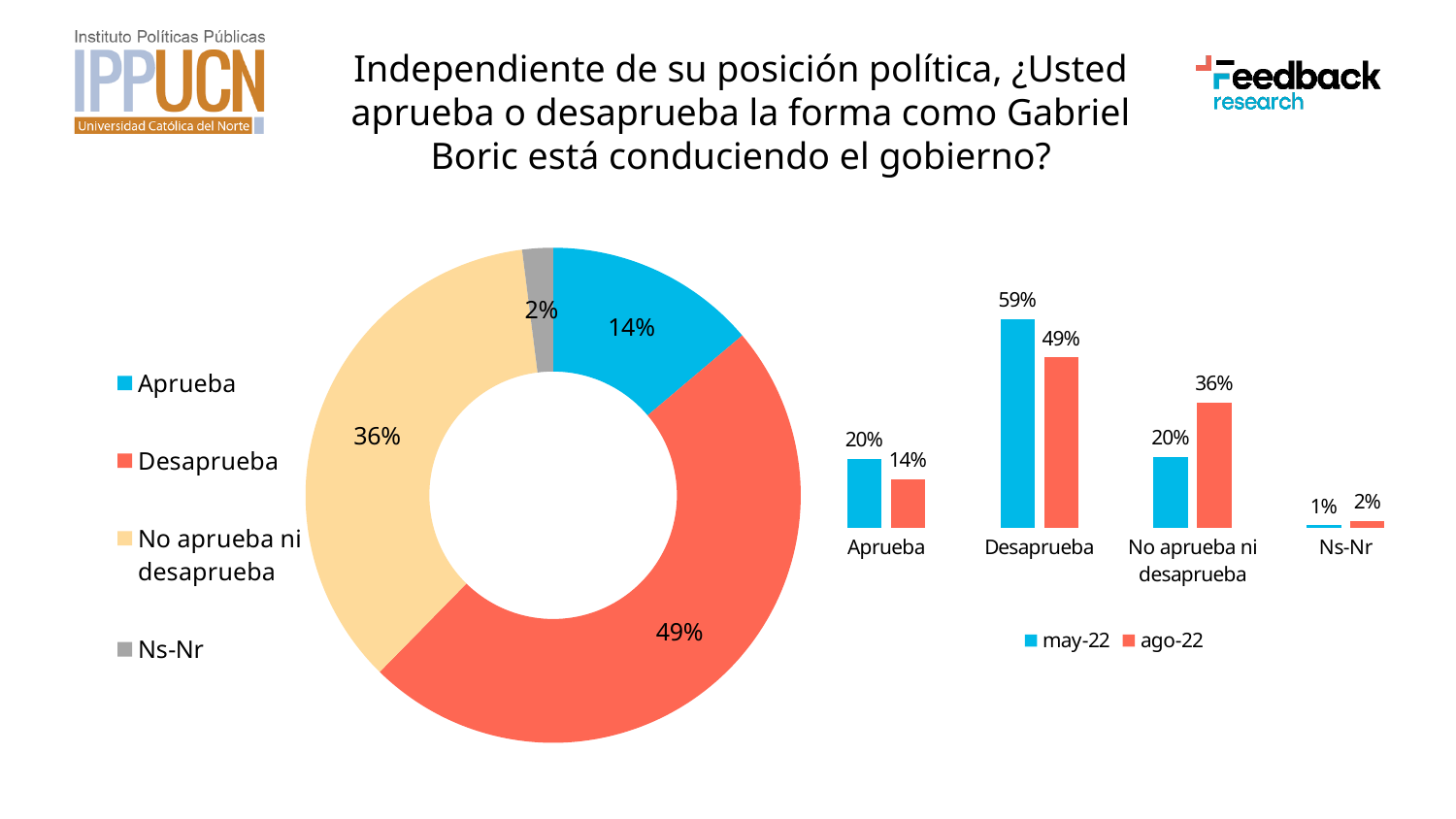
In the doughnut chart on the left, what share is shown for No aprueba ni desaprueba? 36% In the doughnut chart on the left, which category has the largest share? Desaprueba In the doughnut chart on the left, which category has the smallest share? Ns-Nr In the doughnut chart on the left, how many categories does the legend list? 4 In the bar chart on the right, what is the difference between the may-22 and ago-22 values for Desaprueba? 10% In the bar chart on the right, what is the value for Desaprueba in may-22? 59% In the doughnut chart on the left, what share is shown for Desaprueba? 49% In the bar chart on the right, what is the value for No aprueba ni desaprueba in ago-22? 36% In the bar chart on the right, which is larger for Aprueba: the may-22 value or the ago-22 value? may-22 In the bar chart on the right, how many series does the legend list? 2 In the bar chart on the right, what colour represents the ago-22 series? Red/orange What kind of chart is shown on the right side of the slide? Bar chart